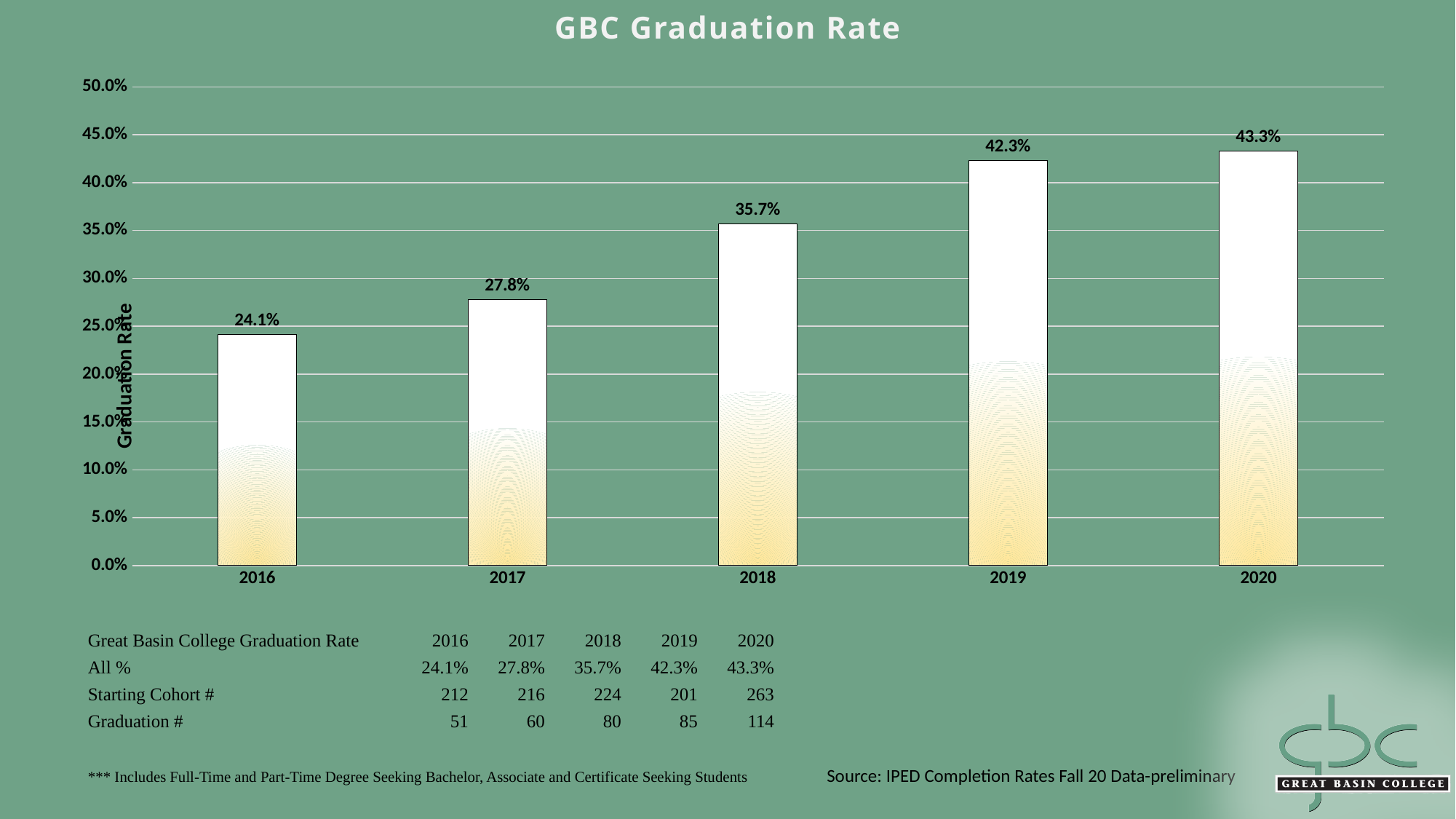
What is the graduation rate for 2018? 35.7% What is the graduation rate for 2016? 24.1% How many years are shown on the chart? 5 Which year has the lowest graduation rate? 2016 Which year has a higher graduation rate, 2017 or 2018? 2018 What kind of chart is shown on the slide? bar chart Which year has the highest graduation rate? 2020 What is the label on the vertical axis of the chart? Graduation Rate Does the graduation rate rise or fall from 2016 to 2020? rise What is the title of the chart? GBC Graduation Rate What is the difference in graduation rate between 2019 and 2018? 6.6% Is the graduation rate for 2017 greater or less than 30.0%? less